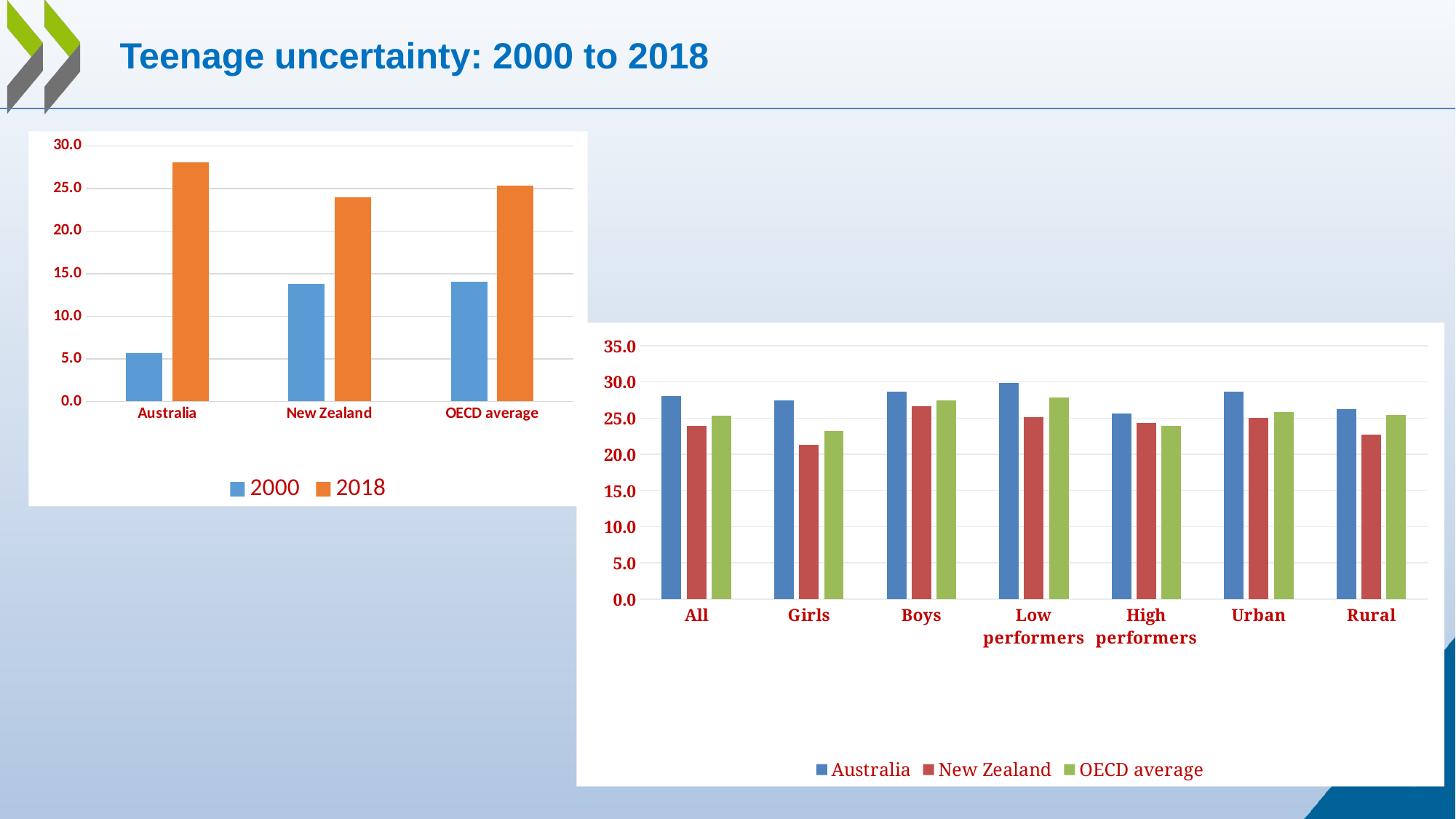
In the left chart, is the 2018 value for Australia greater or less than 25.0? greater In the left chart, which category has the lowest 2000 value? Australia In the left chart, how many categories are shown on the x axis? 3 In the right chart, which category has the lowest New Zealand value? Girls In the right chart, how many series does the legend list? 3 In the left chart, is the 2000 value for Australia greater or less than 10.0? less In the left chart, how many series does the legend list? 2 In the left chart, which is larger for New Zealand: the 2000 value or the 2018 value? 2018 In the left chart, which category has the highest 2018 value? Australia In the right chart, is the Australia value for Low performers greater or less than 25.0? greater In the right chart, how many categories are shown on the x axis? 7 In the left chart, what kind of chart is shown? bar chart